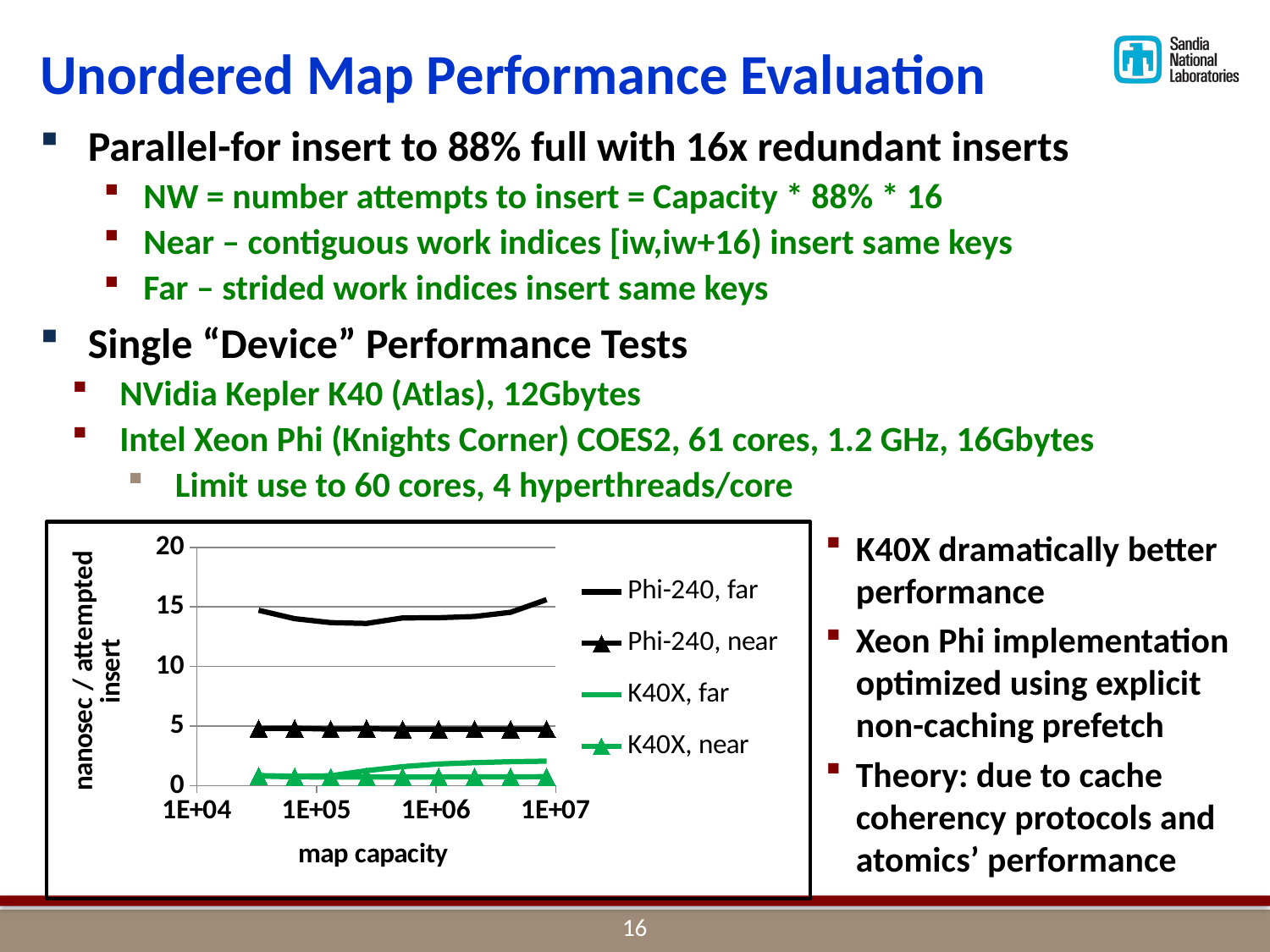
Is the value for Phi-240, far at a map capacity of 1E+06 greater or less than 10? greater Is the value for K40X, far at a map capacity of 1E+05 greater or less than 5? less Is the value for Phi-240, near at a map capacity of 1E+06 greater or less than 10? less Which series has the lowest values across the chart? K40X, near What is the label of the x axis of the chart? map capacity Which series has larger values, Phi-240, near or K40X, far? Phi-240, near What kind of chart is shown on the slide? line chart Which series has the highest values across the chart? Phi-240, far What is the label of the y axis of the chart? nanosec / attempted insert Does the K40X, far series rise or fall as map capacity increases from 1E+05 to 1E+07? rise How many series does the chart legend list? 4